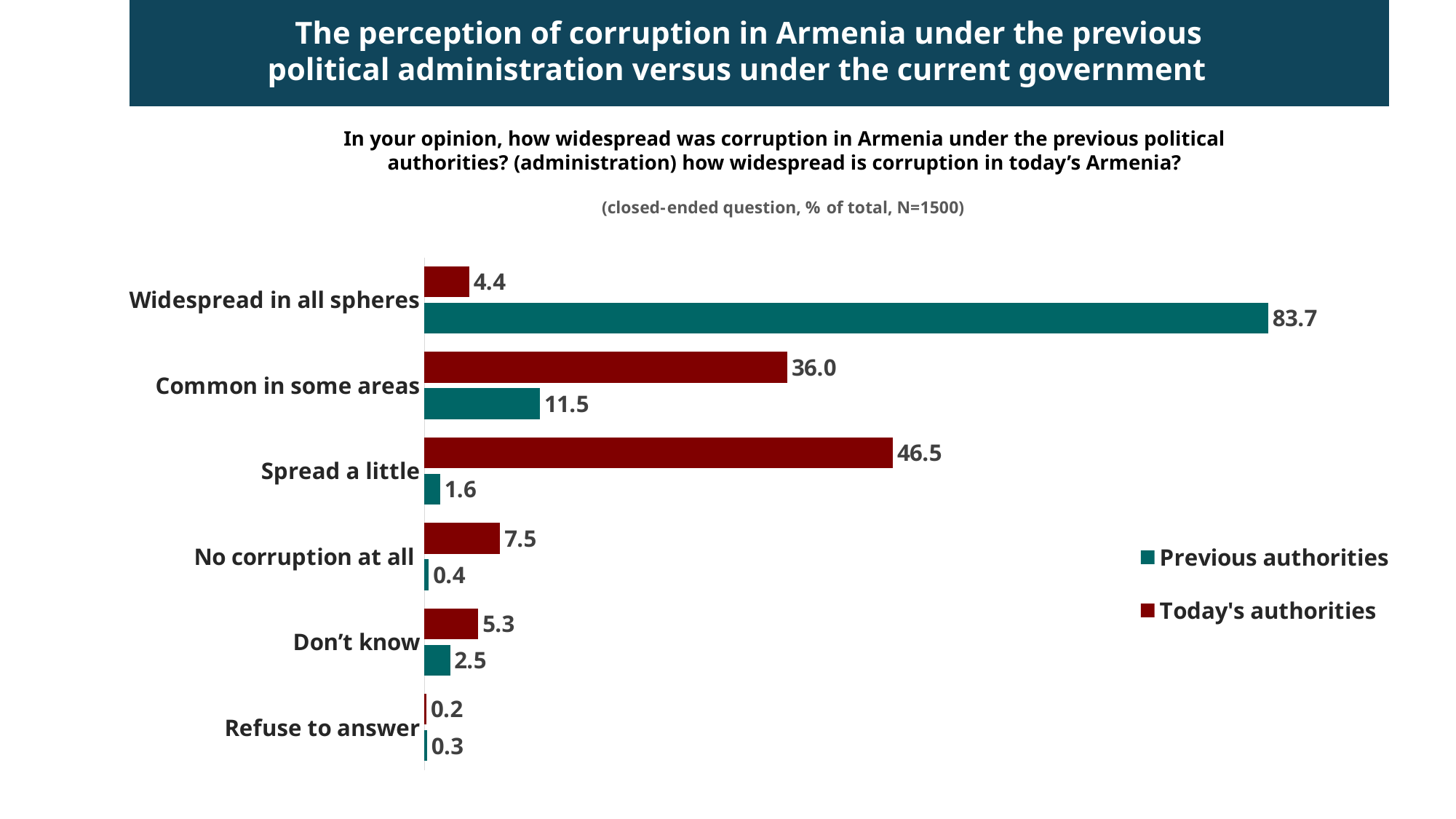
What is the difference between the Previous authorities and Today's authorities values for "Widespread in all spheres"? 79.3 Which series is shown in dark red in the legend? Today's authorities For "Common in some areas", which series has the larger value: Previous authorities or Today's authorities? Today's authorities What is the value for "Widespread in all spheres" for Previous authorities? 83.7 What is the value for "Don't know" for Today's authorities? 5.3 Which category has the highest value for Today's authorities? Spread a little How many series does the legend list? 2 What kind of chart is shown on the slide? Bar chart Which category has the lowest value for Previous authorities? Refuse to answer How many categories are shown on the chart? 6 What is the value for "Spread a little" for Today's authorities? 46.5 What is the value for "Common in some areas" for Previous authorities? 11.5